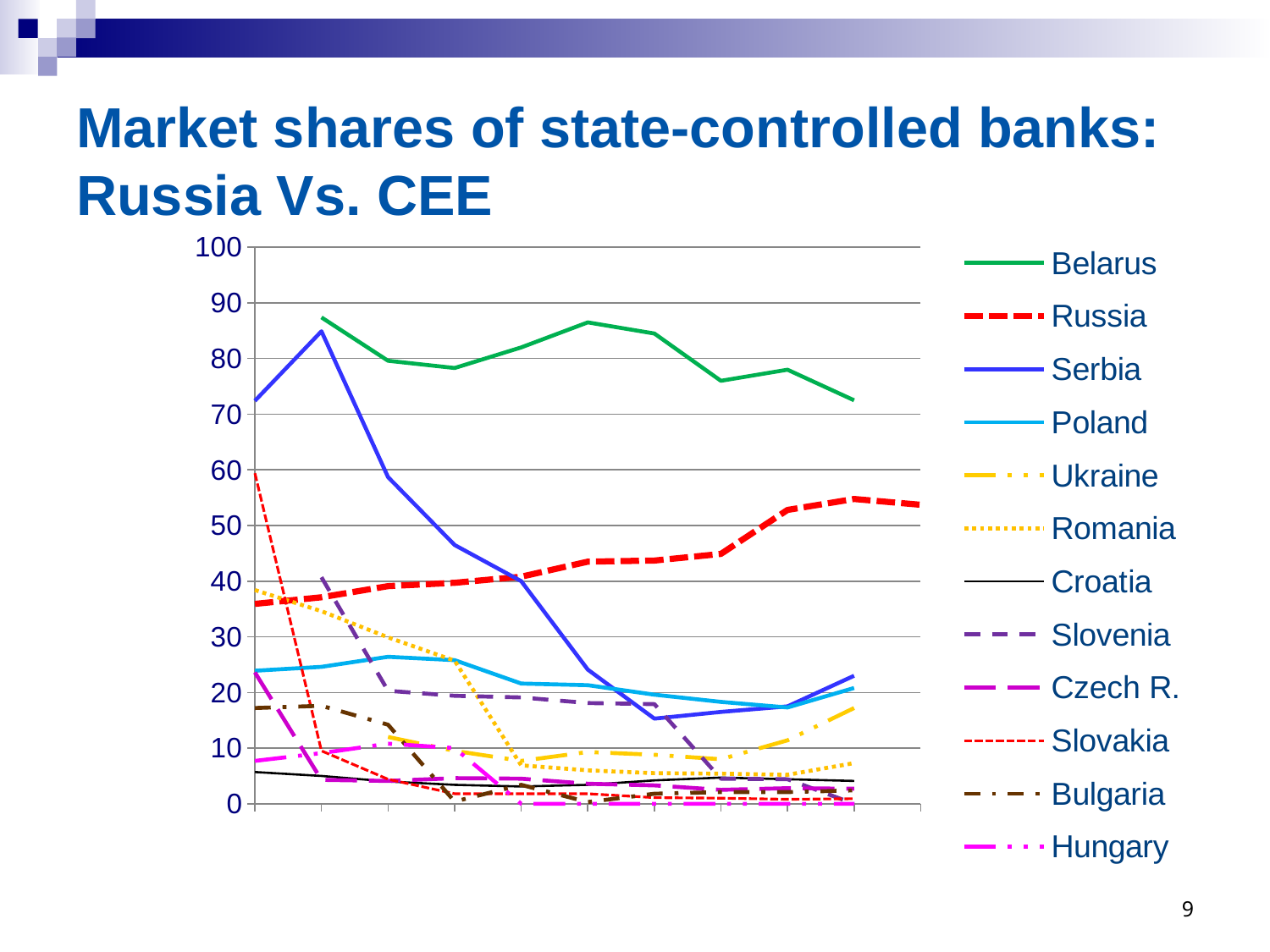
How many series does the legend list? 12 Is the value for Russia at the right end of the chart greater or less than 50? greater At the right end of the chart, which is larger, the value for Belarus or the value for Russia? Belarus Does the Russia line rise or fall overall from left to right? rise Is the peak value of the Belarus line greater or less than 80? greater What is the title of the slide's chart? Market shares of state-controlled banks: Russia Vs. CEE Does the Serbia line rise or fall overall from left to right? fall What kind of chart is shown on the slide? line chart Which series has the highest value at the first point on the left of the chart? Serbia Is the value for Poland at the left end of the chart greater or less than 30? less Which series is drawn as a thick red dashed line? Russia Which series has the highest value at the right end of the chart? Belarus